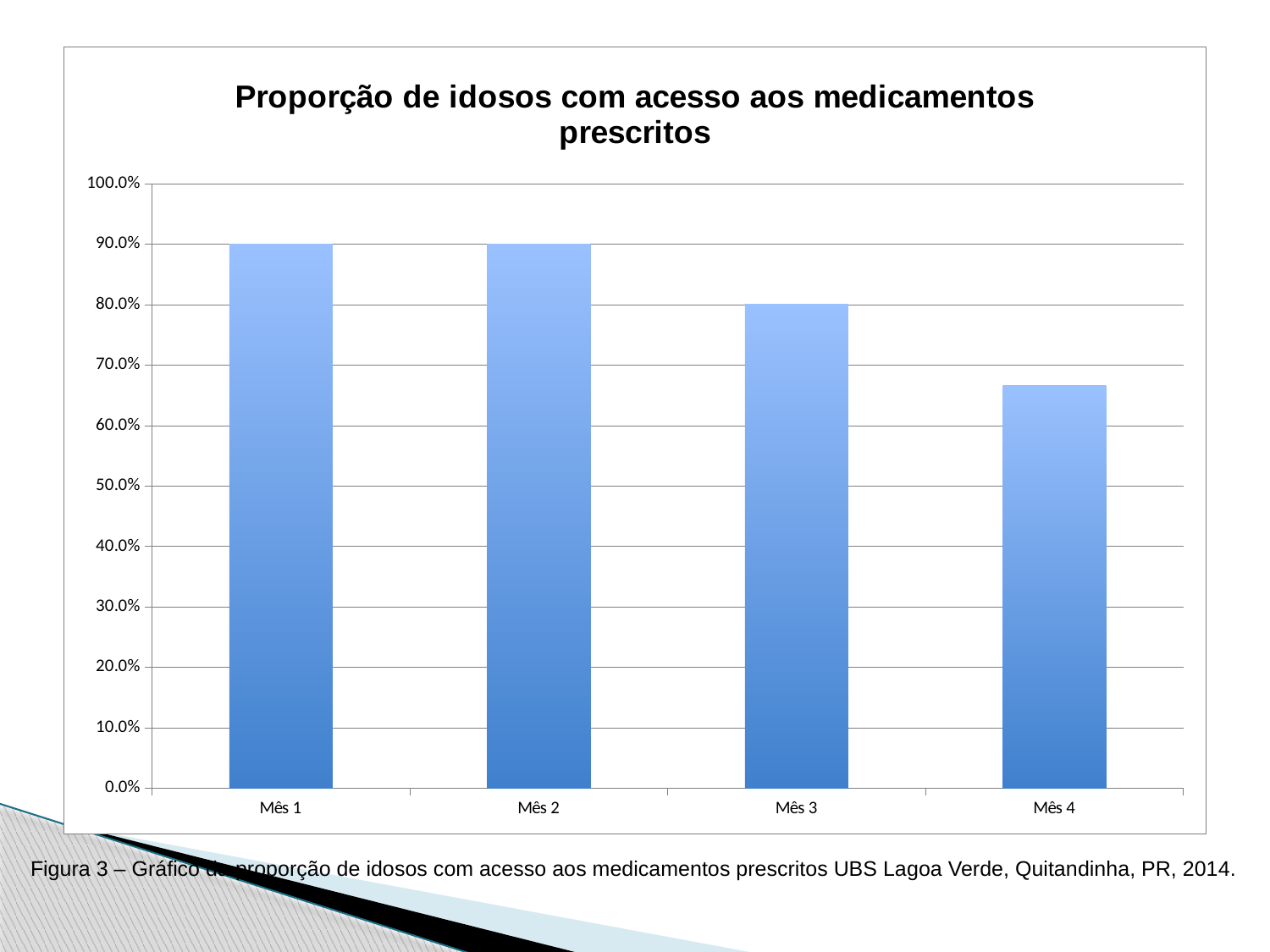
What is the difference between the values for Mês 1 and Mês 3? 10.0% What is the value for Mês 2? 90.0% Do the values rise or fall from Mês 1 to Mês 4? fall Which month has the lowest proportion? Mês 4 What is the title of the chart? Proporção de idosos com acesso aos medicamentos prescritos Which is larger, the value for Mês 3 or the value for Mês 4? Mês 3 How many categories (months) are shown on the x axis? 4 What is the value for Mês 3? 80.0% Is the value for Mês 4 greater or less than 70.0%? less What kind of chart is shown on the slide? bar chart Is the value for Mês 4 greater or less than 60.0%? greater What is the value for Mês 1? 90.0%